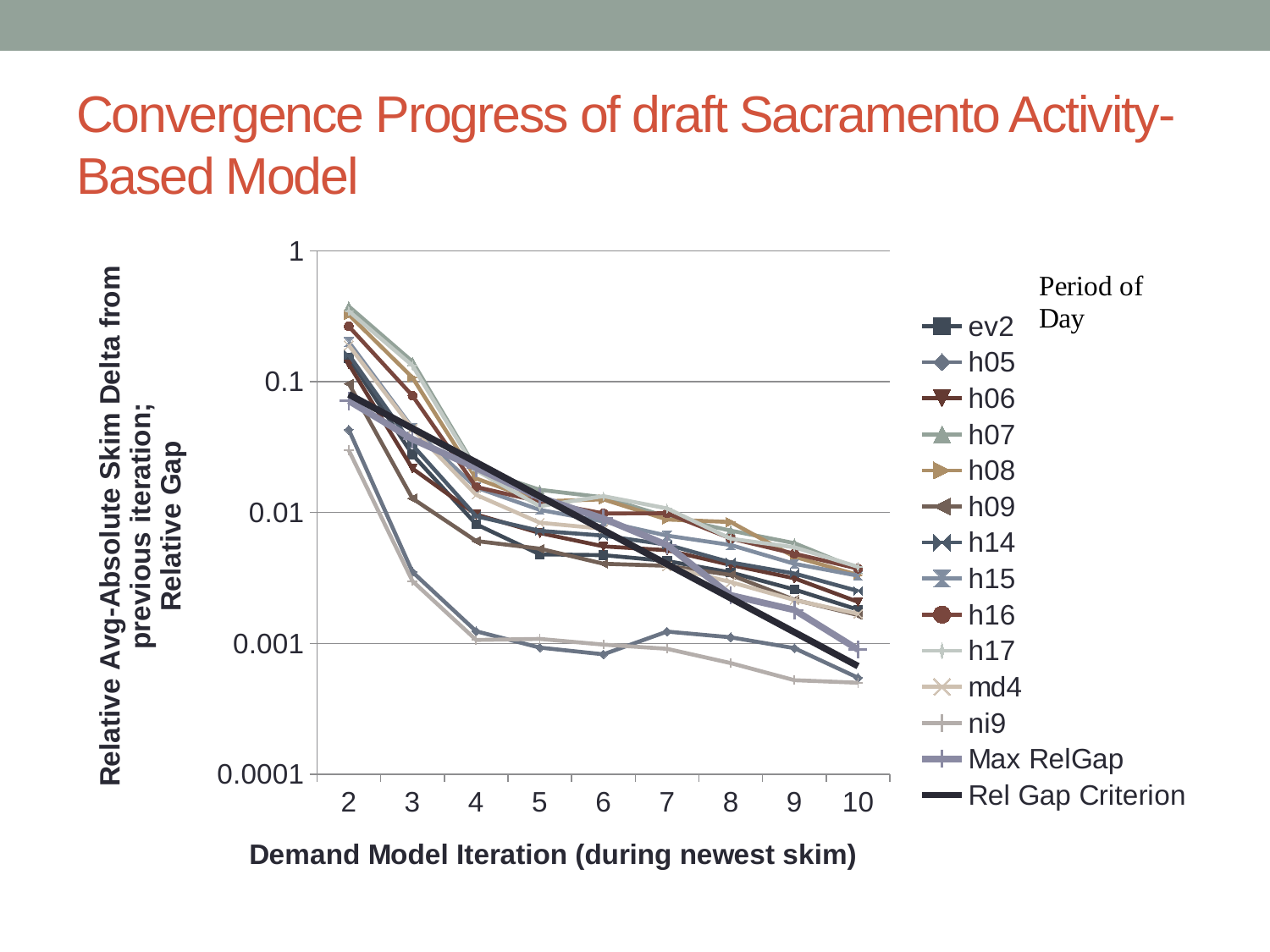
Is the value for Rel Gap Criterion at iteration 10 greater or less than 0.001? less What kind of chart is shown on the slide? line chart What is the title of the legend? Period of Day Does the Rel Gap Criterion line rise or fall as the iteration number increases? fall Is the value for ni9 at iteration 10 greater or less than 0.001? less How many demand model iterations are shown along the x axis? 9 Is the value for h07 at iteration 2 greater or less than 0.1? greater At iteration 2, which is larger: the value for h07 or the value for ni9? h07 What is the x-axis title of the chart? Demand Model Iteration (during newest skim) How many series does the legend list? 14